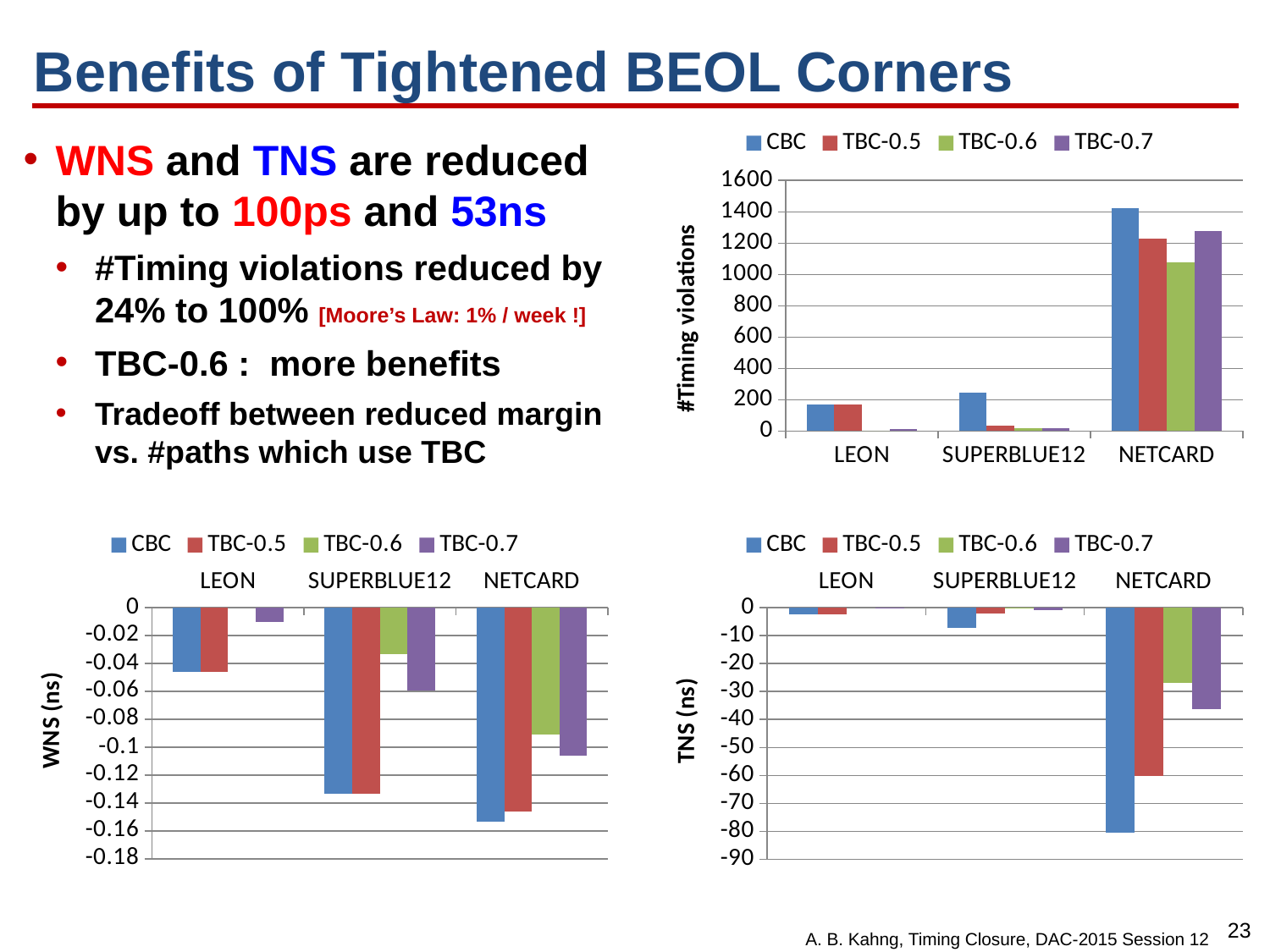
In the '#Timing violations' chart, is the TBC-0.6 value for NETCARD greater or less than 1200? less In the '#Timing violations' chart, how many categories are shown on the x axis? 3 In the 'WNS (ns)' chart at the bottom left, which series has the most negative WNS for NETCARD? CBC In the '#Timing violations' chart, is the CBC value for NETCARD greater or less than 1200? greater In the 'TNS (ns)' chart at the bottom right, is the CBC value for NETCARD greater or less than -70? less In the 'TNS (ns)' chart at the bottom right, which category has the most negative TNS values? NETCARD In the '#Timing violations' chart, how many series does the legend list? 4 What kind of chart is the '#Timing violations' chart at the top right of the slide? bar chart In the '#Timing violations' chart, for NETCARD, which is larger: the CBC value or the TBC-0.6 value? CBC What are the legend entries of the 'WNS (ns)' chart at the bottom left? CBC, TBC-0.5, TBC-0.6, TBC-0.7 In the '#Timing violations' chart, which category has the highest number of timing violations? NETCARD